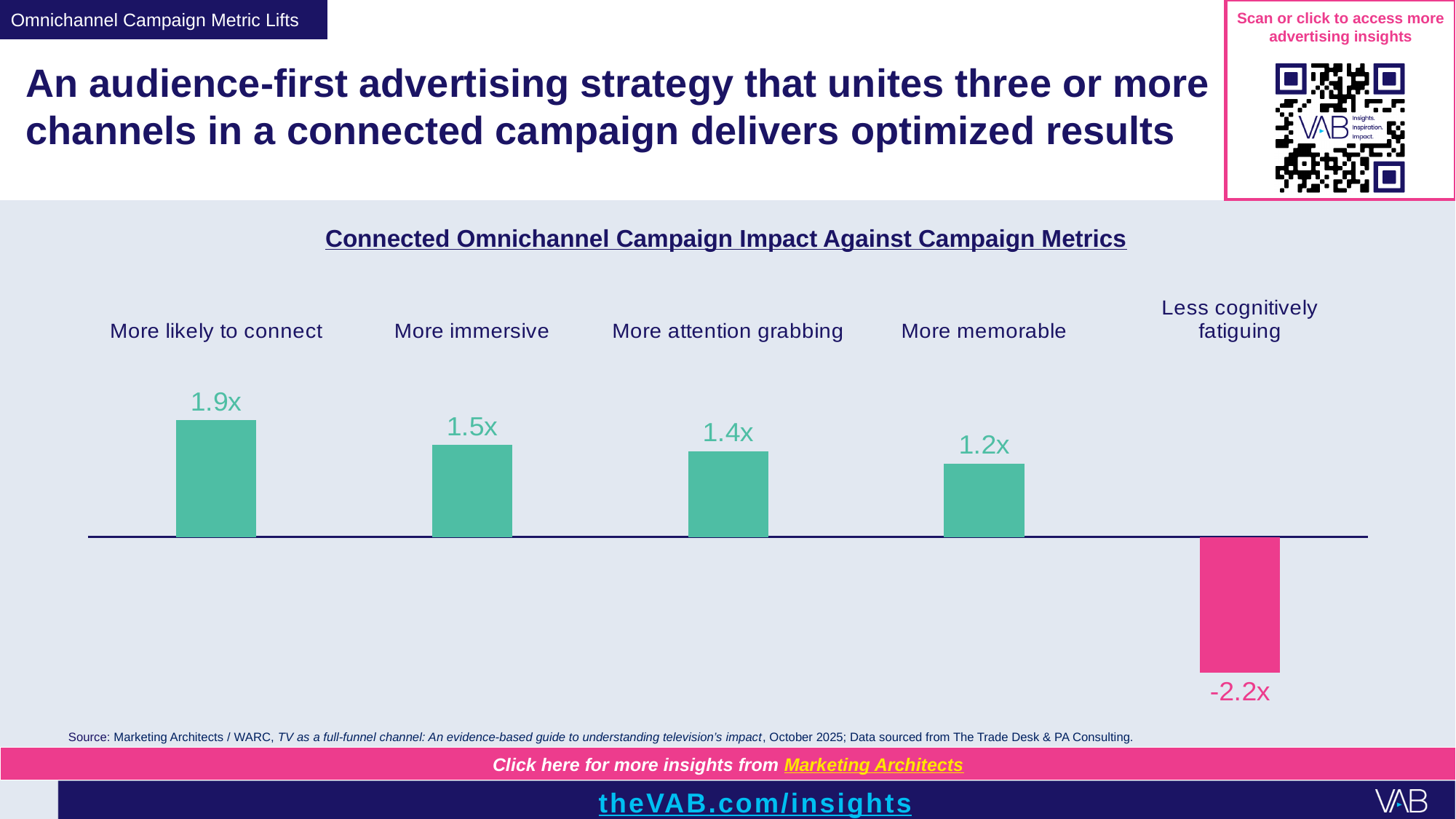
What kind of chart is shown on the slide? Bar chart What is the value for Less cognitively fatiguing? -2.2x What is the value for More likely to connect? 1.9x What is the value for More immersive? 1.5x How many categories are shown in the chart? 5 What is the value for More attention grabbing? 1.4x What is the title of the chart? Connected Omnichannel Campaign Impact Against Campaign Metrics What is the difference between the values for More likely to connect and More memorable? 0.7x Which category has the lowest value? Less cognitively fatiguing What is the value for More memorable? 1.2x Which category has the highest value? More likely to connect Which is larger, the value for More immersive or the value for More attention grabbing? More immersive